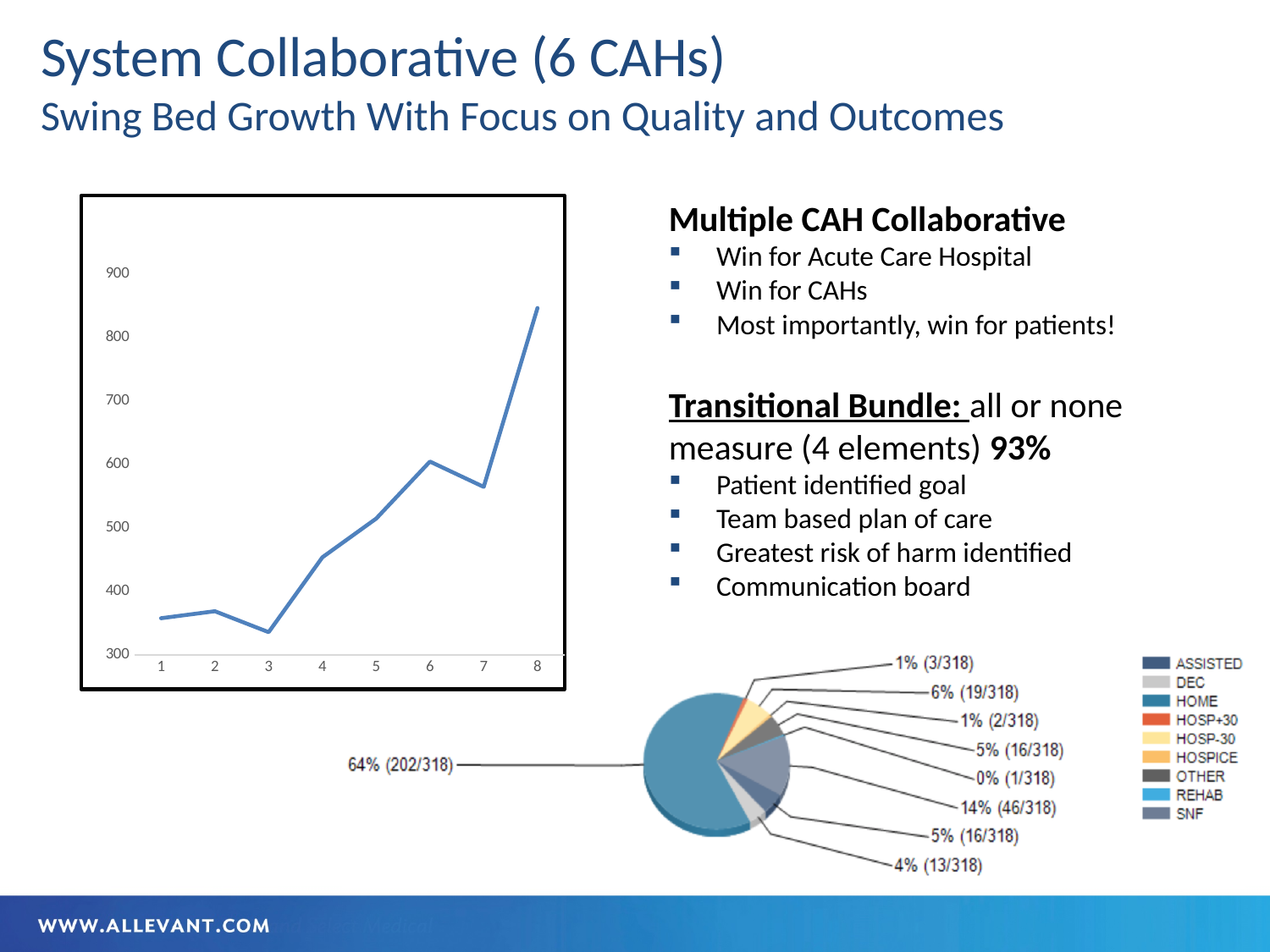
In the line chart on the left, do the values generally rise or fall from point 1 to point 8? rise In the pie chart at the bottom right, what share does the largest slice have? 64% (202/318) What kind of chart is the chart at the bottom right of the slide? pie chart In the line chart on the left, which is larger, the value at point 6 or the value at point 7? point 6 In the line chart on the left, at which x-axis point is the value lowest? 3 How many entries does the legend of the pie chart at the bottom right list? 9 In the line chart on the left, is the value at point 6 greater or less than 500? greater In the line chart on the left, how many points are plotted along the x axis? 8 In the line chart on the left, at which x-axis point is the value highest? 8 In the line chart on the left, is the value at point 8 greater or less than 800? greater What kind of chart is the chart on the left of the slide? line chart In the line chart on the left, is the value at point 3 greater or less than 400? less